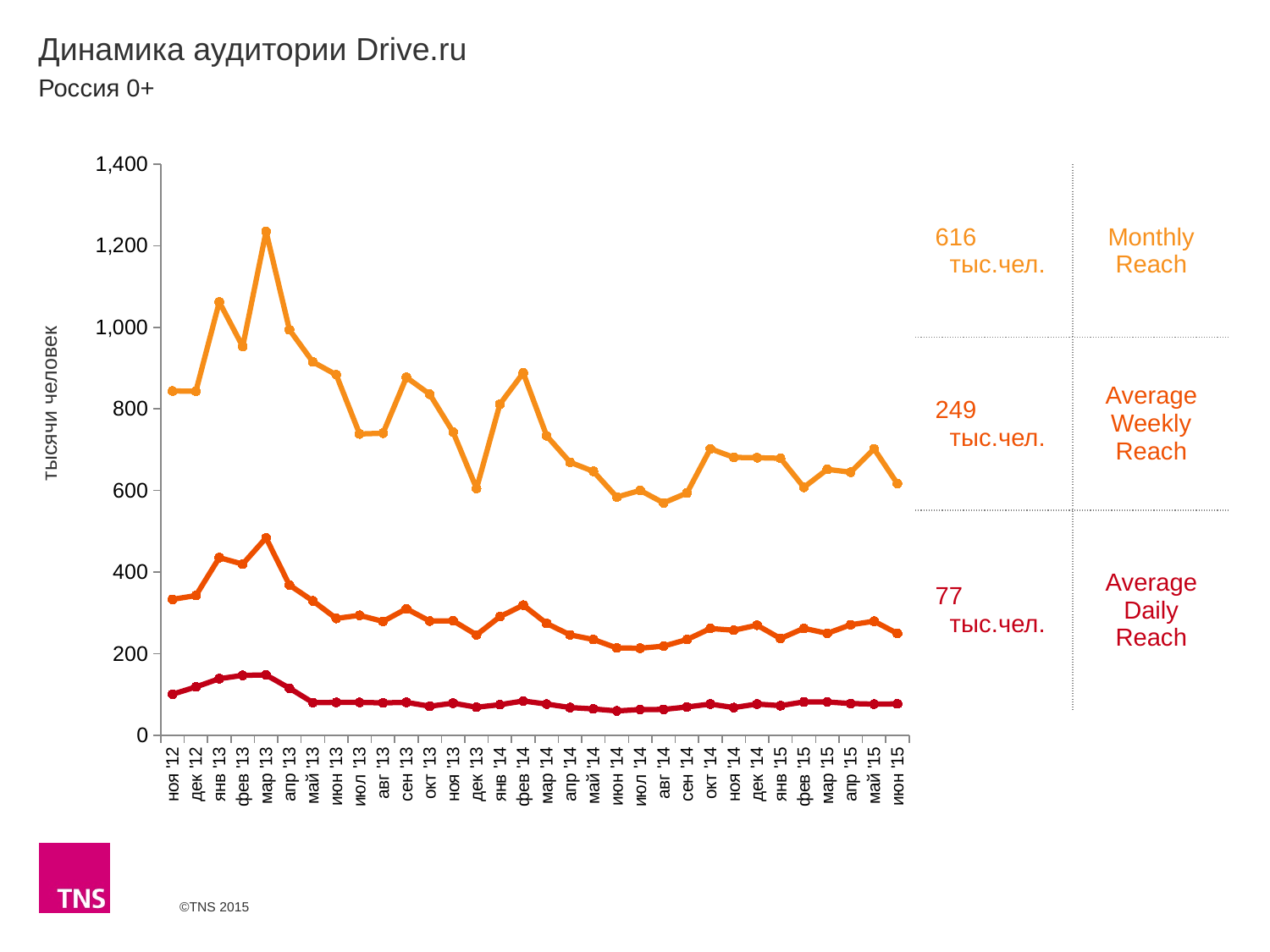
What is the Monthly Reach value shown for июн '15? 616 тыс.чел. How many months are shown on the x axis? 32 What is the Average Weekly Reach value shown for июн '15? 249 тыс.чел. Is the Monthly Reach value for мар '13 greater or less than 1,000? greater How many series are plotted on the chart? 3 In which month does the Monthly Reach line reach its highest point? мар '13 Which is larger: the Monthly Reach in мар '13 or the Monthly Reach in июн '15? мар '13 What kind of chart is shown on the slide? line chart Is the Monthly Reach value for дек '13 greater or less than 800? less What is the Average Daily Reach value shown for июн '15? 77 тыс.чел. Is the Average Daily Reach value for мар '13 greater or less than 200? less What is the difference between the Monthly Reach and the Average Weekly Reach values shown for июн '15? 367 тыс.чел.